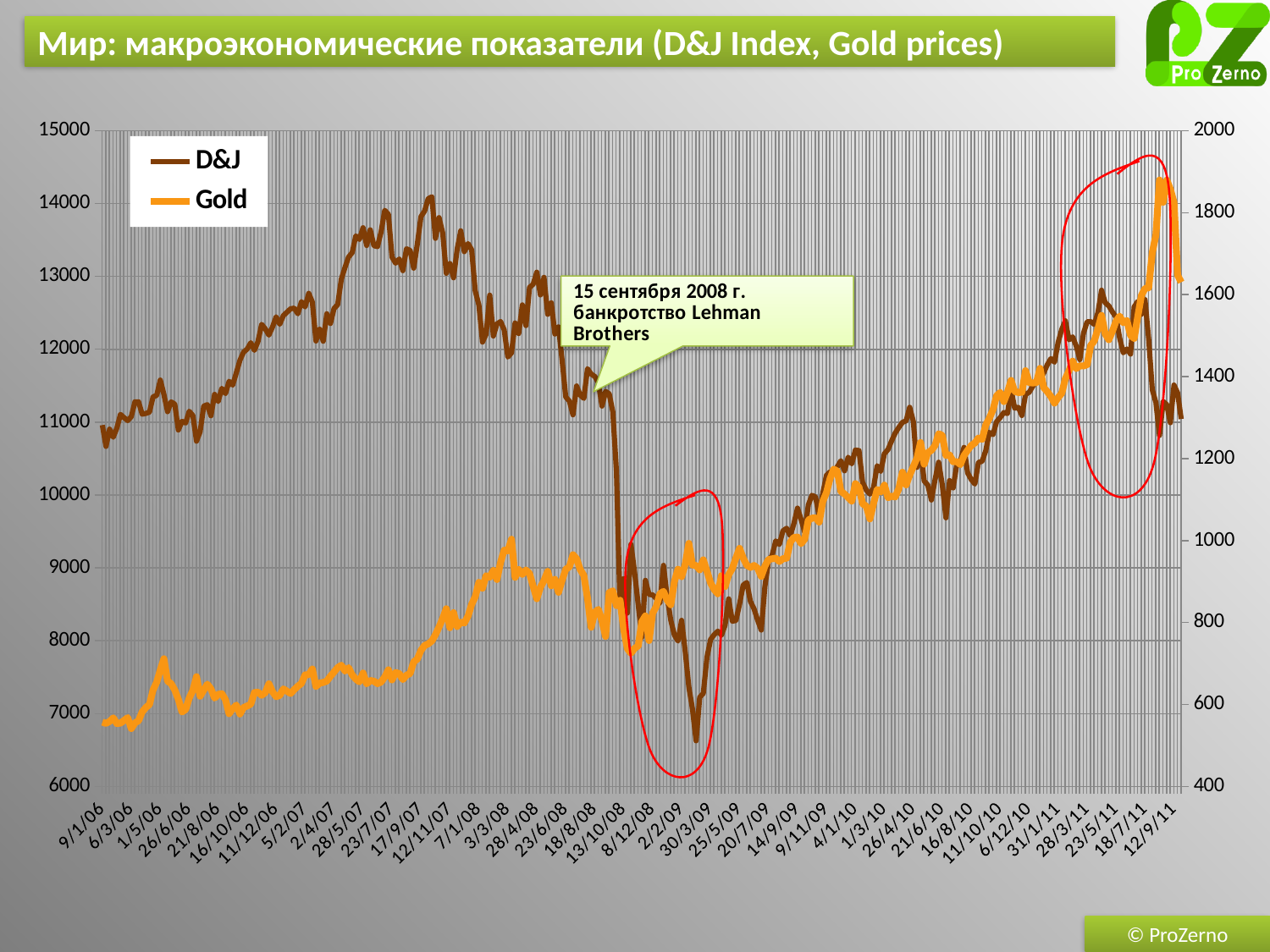
What event does the callout on the chart mark on 15 September 2008? Bankruptcy of Lehman Brothers Is the Gold value at the end of the chart (12/9/11) greater or less than 1400? greater What kind of chart is shown on the slide? line chart How many series does the legend list? 2 Is the Gold value at the start of the chart (9/1/06) greater or less than 600? less Is the D&J value around 30/3/09 greater or less than the D&J value around 12/11/07? less What is the maximum value shown on the left vertical axis? 15000 Does the Gold series overall rise or fall from the start of the chart to the end? rise Is the Gold value at its peak in 2011 greater or less than 1800? greater What are the two series named in the legend? D&J and Gold